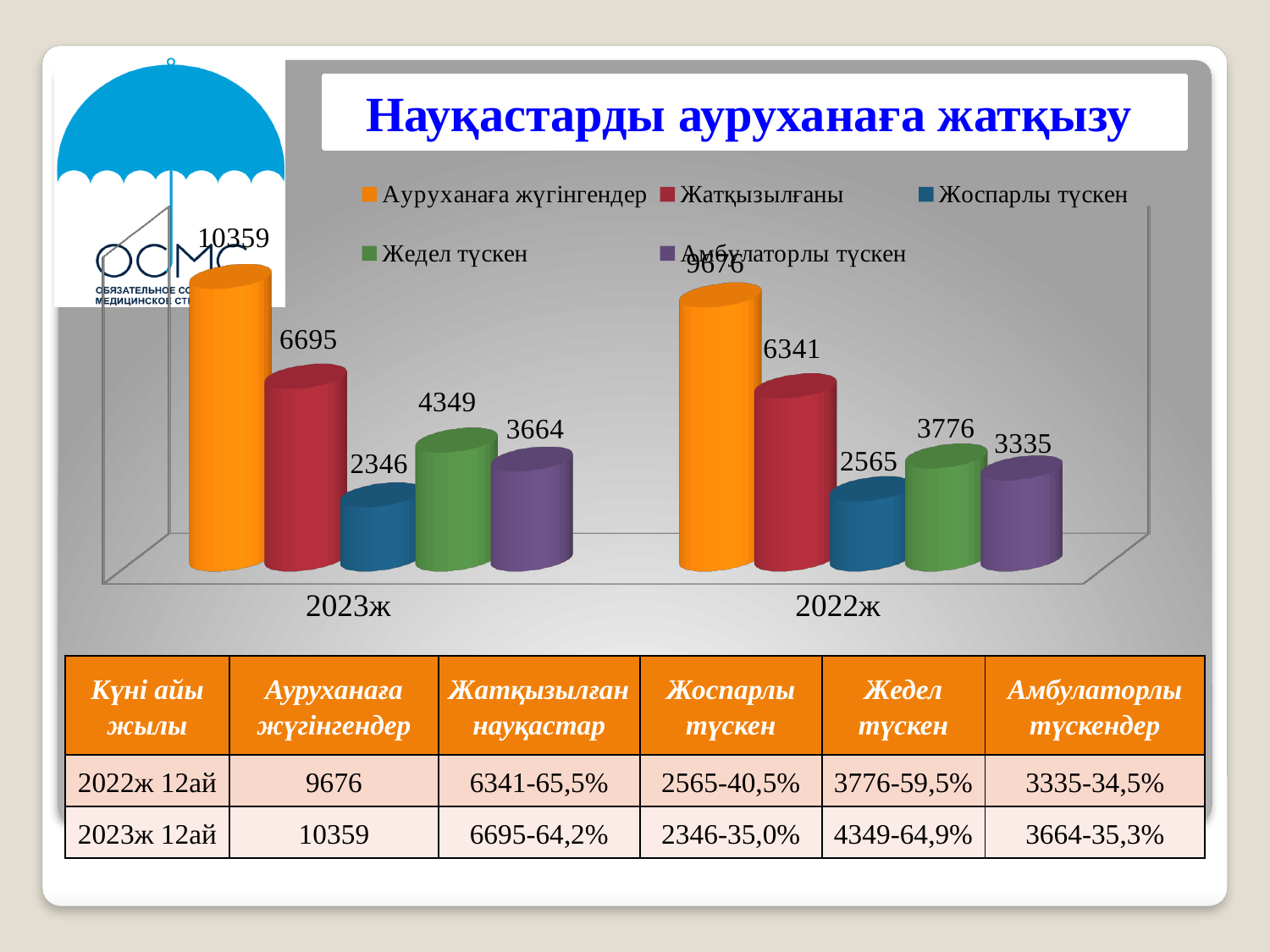
What is the difference between Ауруханаға жүгінгендер for 2023ж and for 2022ж? 683 What is the value of Жоспарлы түскен for 2023ж? 2346 Which series has the lowest value for 2023ж? Жоспарлы түскен What is the value of Ауруханаға жүгінгендер for 2023ж? 10359 Which is larger: Жедел түскен for 2023ж or Жедел түскен for 2022ж? 2023ж How many series does the chart legend list? 5 Which series has the highest value for 2022ж? Ауруханаға жүгінгендер How many categories are shown on the x axis of the chart? 2 What is the value of Жедел түскен for 2022ж? 3776 What is the value of Амбулаторлы түскен for 2023ж? 3664 What is the value of Жатқызылғаны for 2022ж? 6341 What type of chart is shown on the slide? Bar chart